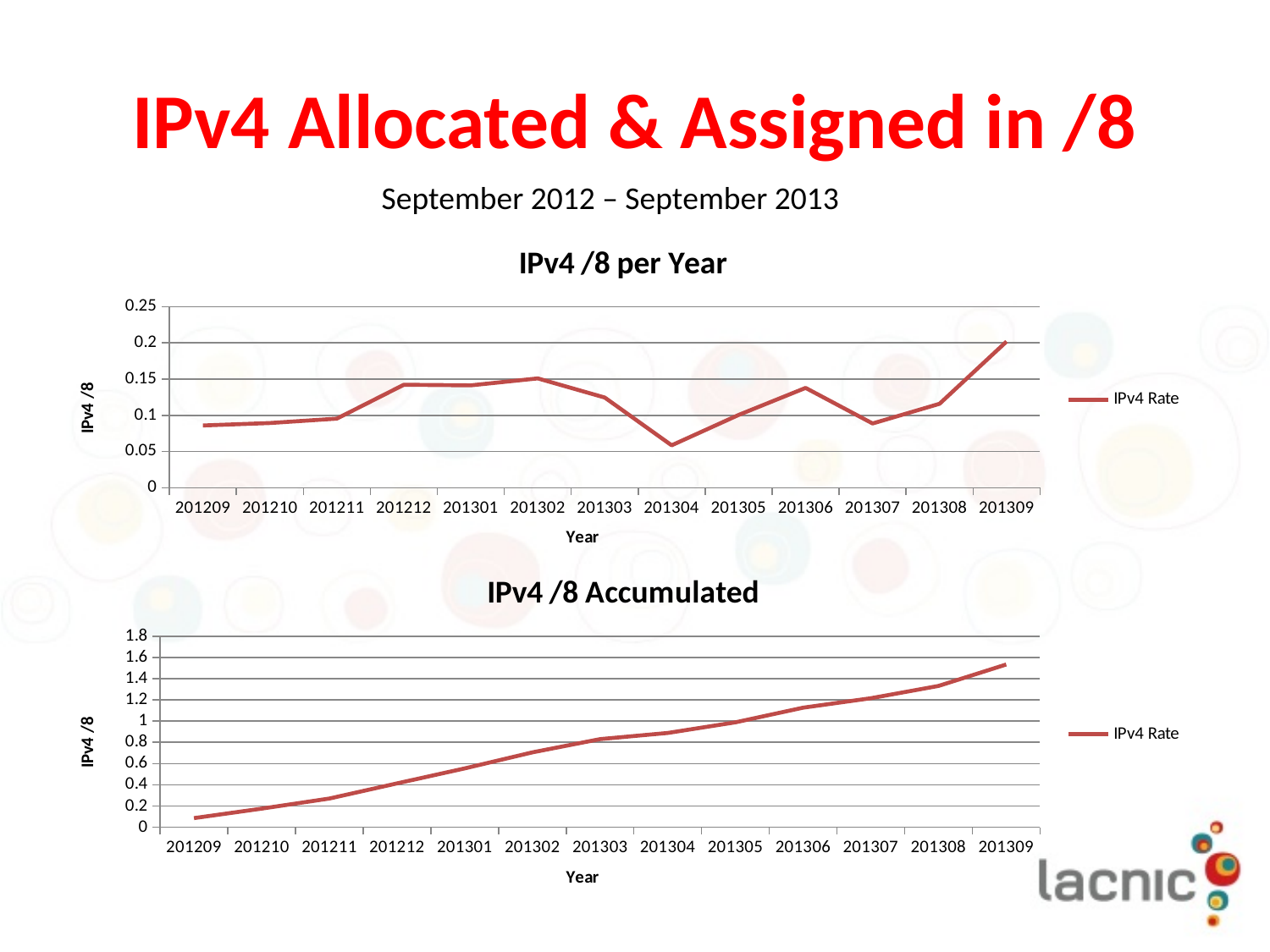
What is the x-axis title of the 'IPv4 /8 Accumulated' chart? Year In the 'IPv4 /8 per Year' chart, is the value for 201309 greater or less than 0.15? greater In the 'IPv4 /8 per Year' chart, which year has the highest IPv4 Rate? 201309 How many series does the legend of the 'IPv4 /8 Accumulated' chart list? 1 In the 'IPv4 /8 Accumulated' chart, which year has the lowest value? 201209 In the 'IPv4 /8 Accumulated' chart, do the values rise or fall from 201209 to 201309? rise In the 'IPv4 /8 per Year' chart, which is larger, the value for 201306 or the value for 201307? 201306 In the 'IPv4 /8 per Year' chart, is the value for 201304 greater or less than 0.1? less What kind of chart is the 'IPv4 /8 per Year' chart? line chart In the 'IPv4 /8 per Year' chart, which year has the lowest IPv4 Rate? 201304 In the 'IPv4 /8 per Year' chart, how many points are plotted along the x axis? 13 In the 'IPv4 /8 Accumulated' chart, is the value for 201309 greater or less than 1.4? greater